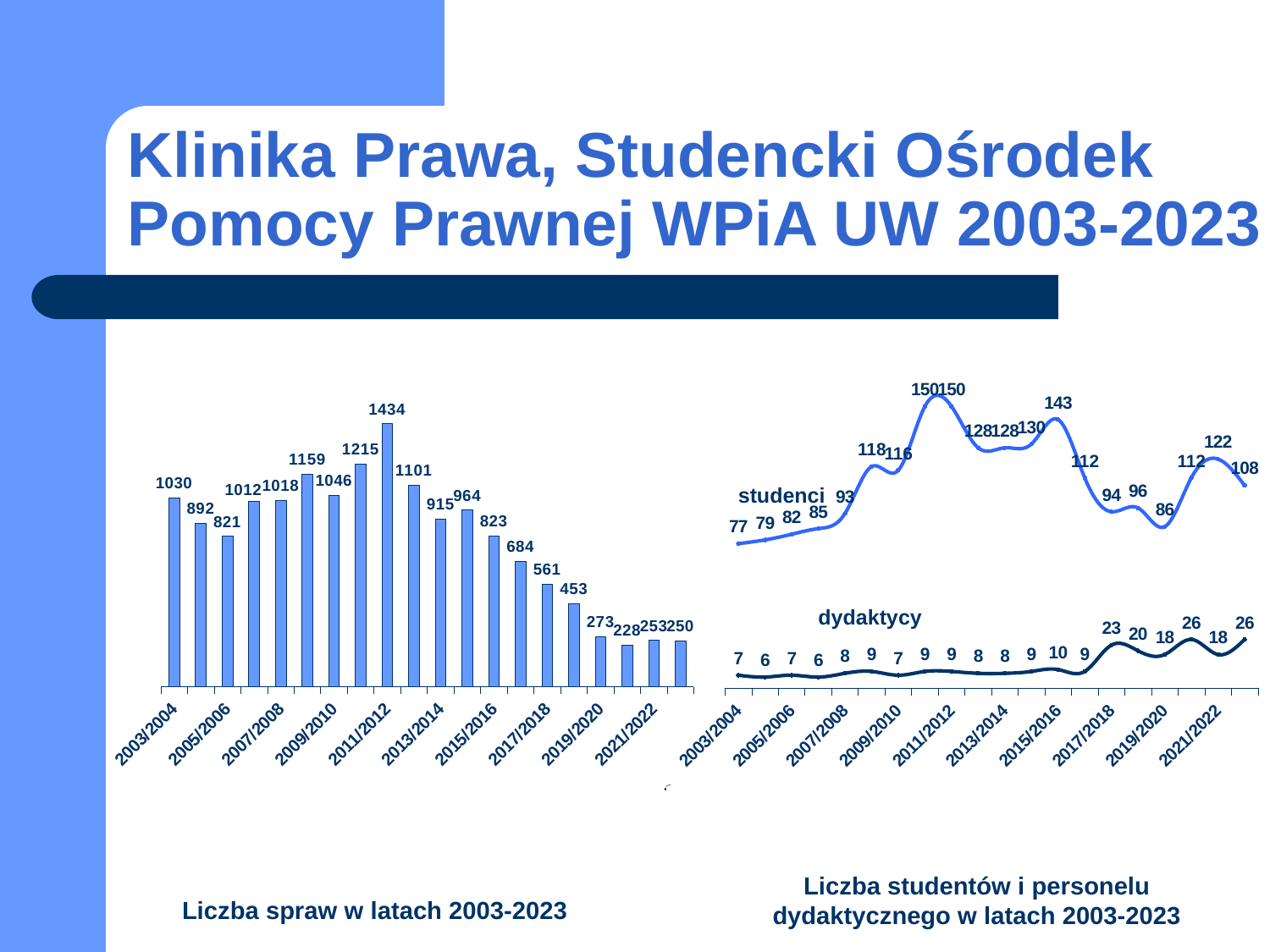
In the right chart (Liczba studentów i personelu dydaktycznego), what is the highest value of the studenci series? 150 In the right chart (Liczba studentów i personelu dydaktycznego), what is the studenci value for 2003/2004? 77 What kind of chart is the right chart (Liczba studentów i personelu dydaktycznego)? line chart How many bars are in the left chart (Liczba spraw w latach 2003-2023)? 20 In the left chart (Liczba spraw w latach 2003-2023), what is the value for 2003/2004? 1030 In the left chart (Liczba spraw w latach 2003-2023), do the values rise or fall from 2011/2012 to 2019/2020? fall In the left chart (Liczba spraw w latach 2003-2023), which year has the highest number of cases? 2011/2012 What kind of chart is the left chart (Liczba spraw w latach 2003-2023)? bar chart In the left chart (Liczba spraw w latach 2003-2023), what is the difference between the values for 2003/2004 and 2005/2006? 209 In the left chart (Liczba spraw w latach 2003-2023), what is the lowest value shown? 228 In the right chart (Liczba studentów i personelu dydaktycznego), which year has the larger studenci value, 2011/2012 or 2021/2022? 2011/2012 How many series are plotted in the right chart (Liczba studentów i personelu dydaktycznego)? 2